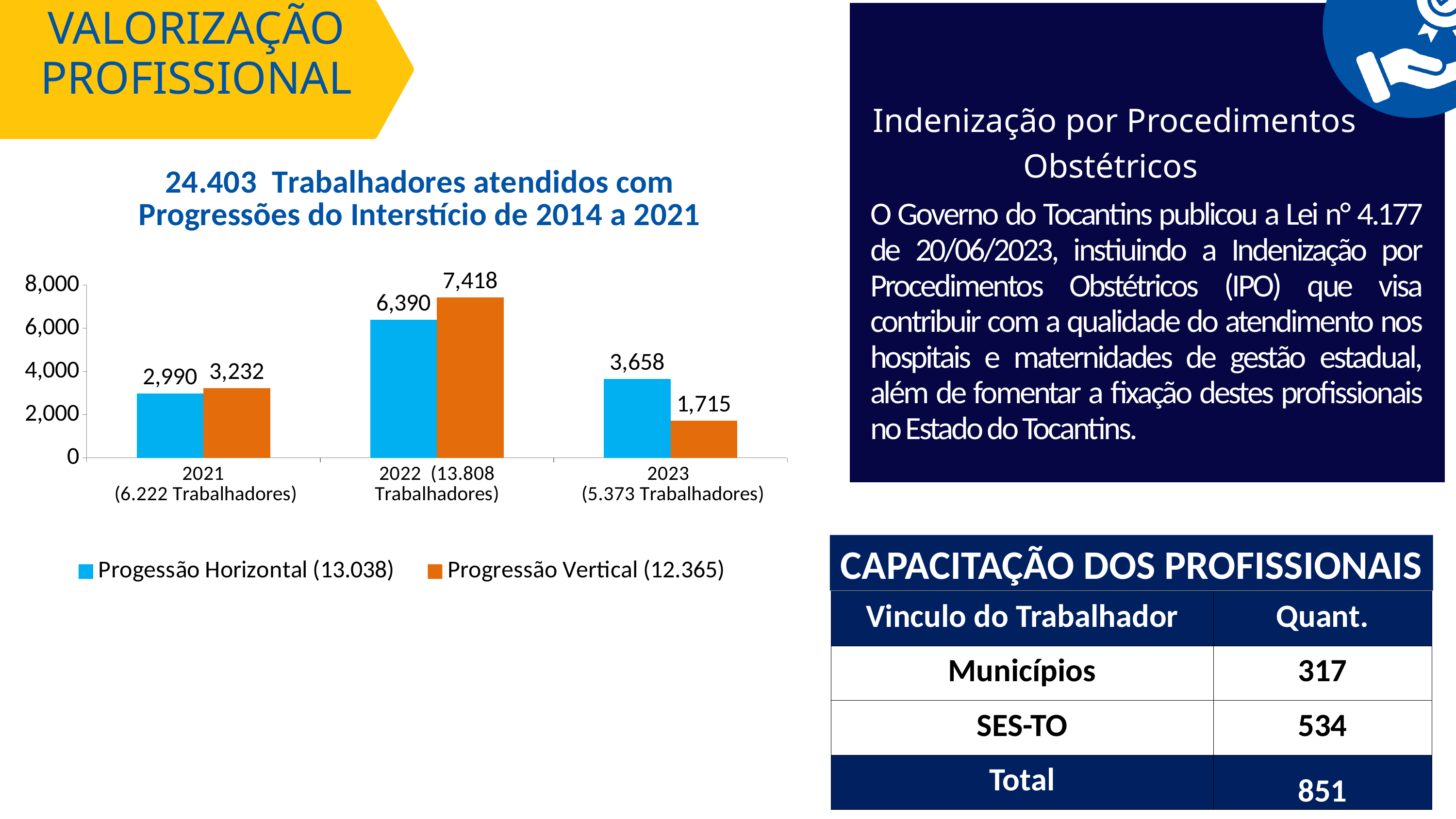
How many series does the chart legend list? 2 What is the value of Progessão Horizontal for 2021? 2,990 Which year has the lowest Progressão Vertical value? 2023 How many years are shown on the x axis of the chart? 3 What is the value of Progressão Vertical for 2023? 1,715 In 2023, which is larger: Progessão Horizontal or Progressão Vertical? Progessão Horizontal What is the value of Progressão Vertical for 2022? 7,418 What colour represents Progressão Vertical in the chart? orange What is the difference between Progressão Vertical and Progessão Horizontal in 2022? 1,028 What kind of chart is shown on the slide? bar chart Is the Progessão Horizontal value for 2022 greater or less than 6,000? greater Which year has the highest Progessão Horizontal value? 2022